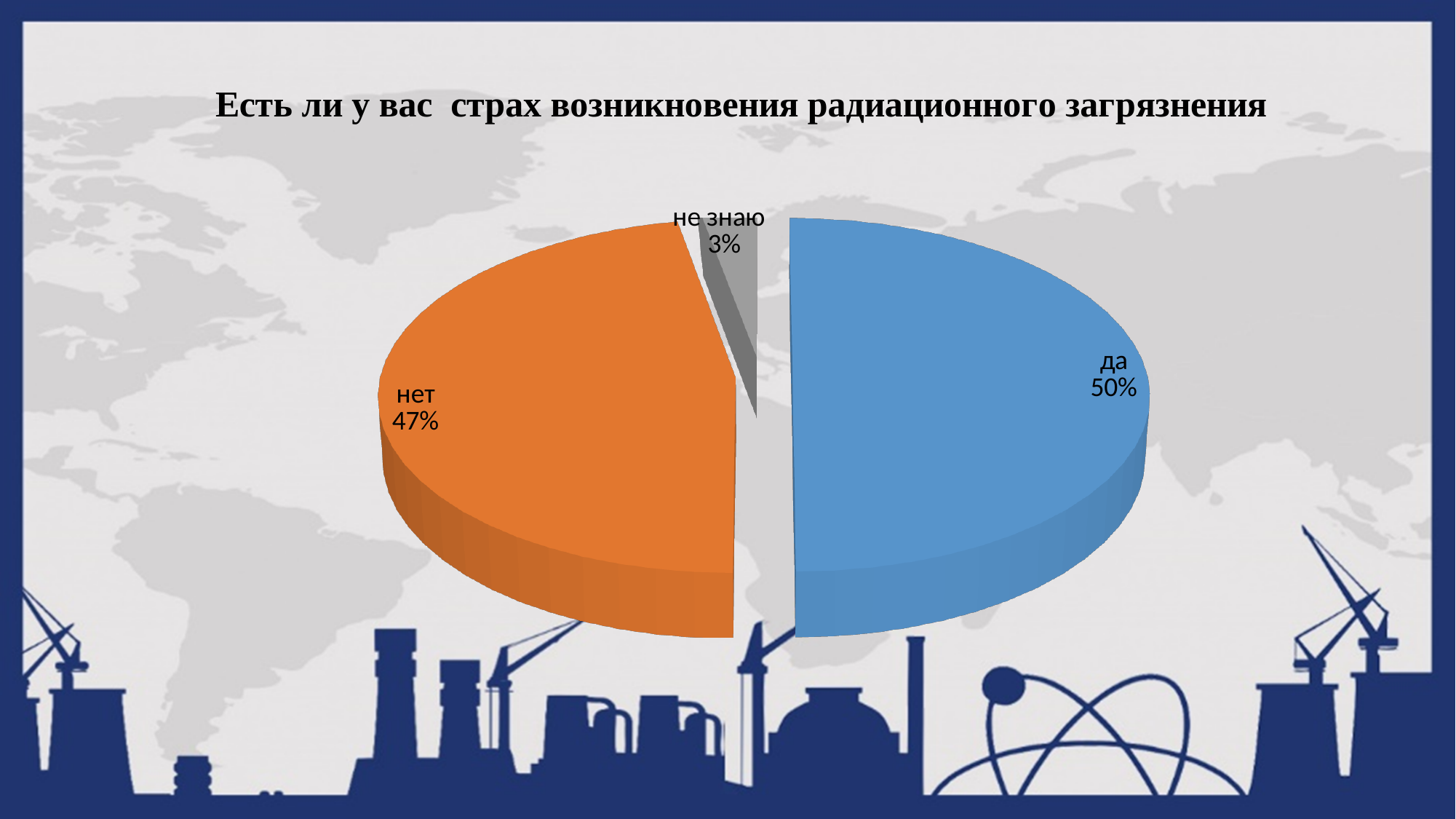
Which category has the largest slice of the pie? да What share of the pie does the "не знаю" slice represent? 3% What is the difference in percentage points between the "нет" and "не знаю" slices? 44 What is the title of the chart? Есть ли у вас страх возникновения радиационного загрязнения What kind of chart is shown on the slide? pie chart What share of the pie does the "да" slice represent? 50% What share of the pie does the "нет" slice represent? 47% What colour is the "да" slice? blue Which slice is larger, "нет" or "не знаю"? нет How many categories are shown in the pie chart? 3 What is the difference in percentage points between the "да" and "нет" slices? 3 Which category has the smallest slice of the pie? не знаю